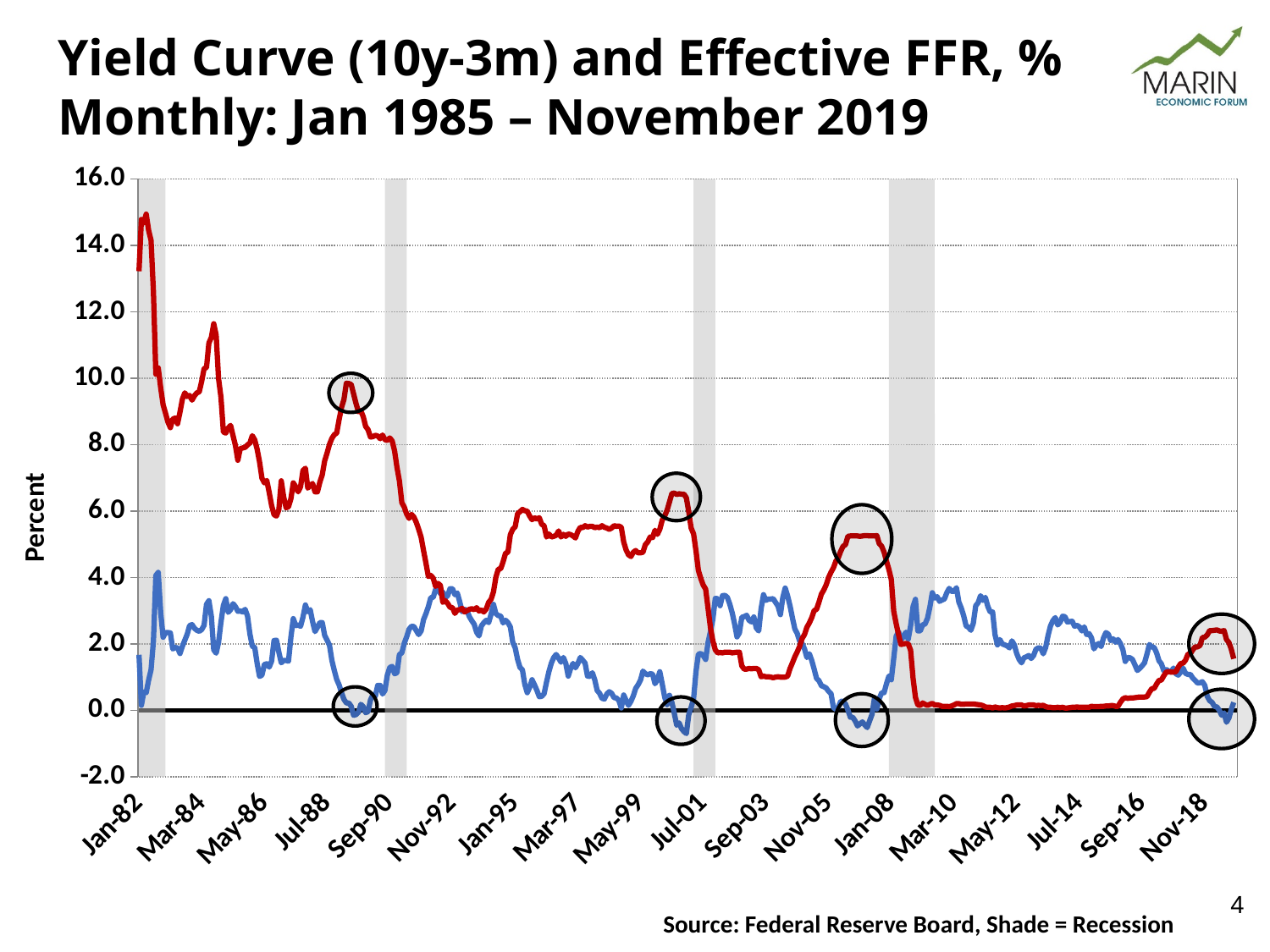
At Jan-82, which line has the larger value, the red line or the blue line? Red line What is the title of the vertical axis? Percent Is the value of the red line near Mar-10 greater or less than 2.0? less Does the red line overall rise or fall from Jan-82 to Nov-18? Fall Is the circled peak of the red line near Sep-90 greater or less than 8.0? greater How many shaded recession bands are shown on the chart? 4 According to the note below the chart, what do the shaded areas represent? Recession What kind of chart is shown on the slide? Line chart Is the value of the blue line near Jan-95 greater or less than 4.0? less What is the highest value shown on the vertical axis? 16.0 How many circled points are marked on the chart? 8